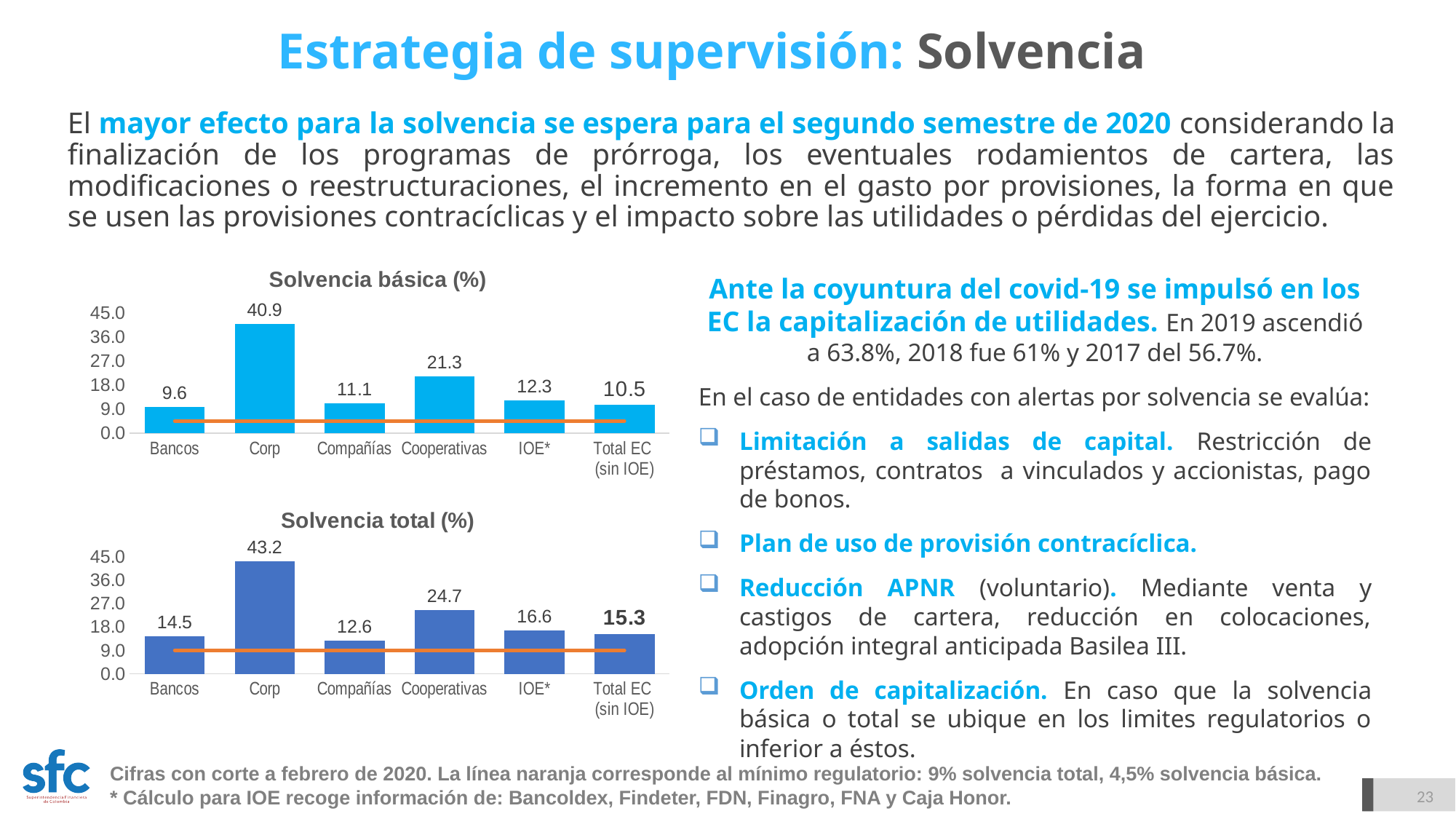
In the 'Solvencia básica (%)' chart, which category has the lowest value? Bancos In the 'Solvencia básica (%)' chart, what is the value for Corp? 40.9 In the 'Solvencia básica (%)' chart, what is the value for Total EC (sin IOE)? 10.5 In the 'Solvencia total (%)' chart, what is the difference between Corp and Total EC (sin IOE)? 27.9 In the 'Solvencia total (%)' chart, what is the value for IOE*? 16.6 In the 'Solvencia básica (%)' chart, what colour are the bars? Light blue In the 'Solvencia básica (%)' chart, what is the difference between Cooperativas and Compañías? 10.2 In the 'Solvencia básica (%)' chart, how many categories are shown? 6 In the 'Solvencia total (%)' chart, which category has the highest value? Corp What type of chart is the 'Solvencia total (%)' chart? Bar chart In the 'Solvencia total (%)' chart, what is the value for Bancos? 14.5 In the 'Solvencia total (%)' chart, which is larger, Cooperativas or IOE*? Cooperativas